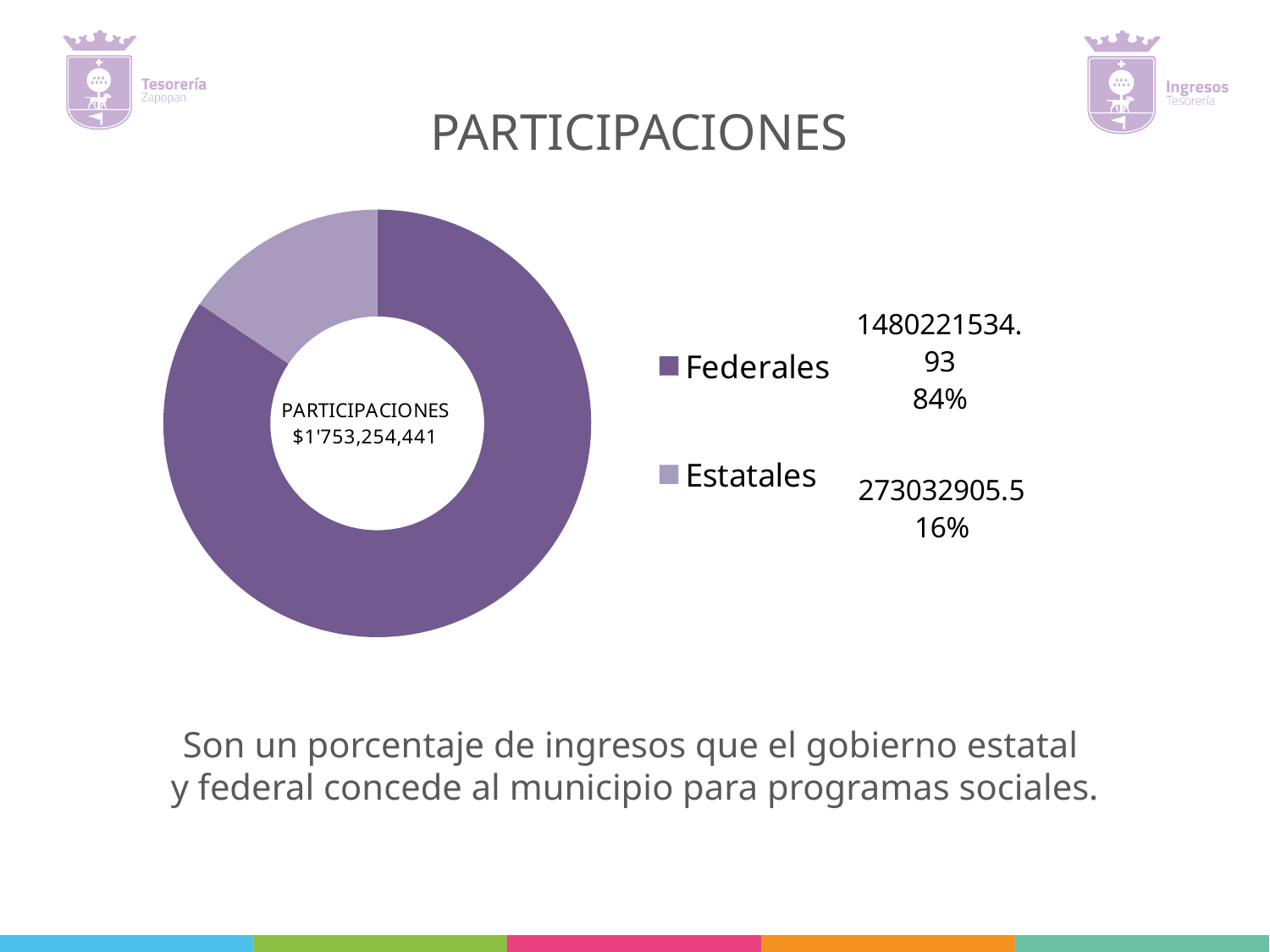
What percentage of the chart does the Estatales slice represent? 16% Which category has the largest slice of the chart? Federales How many categories does the chart show? 2 What total amount is printed in the centre of the chart? $1'753,254,441 Which category has the smallest slice of the chart? Estatales What is the value shown for Estatales? 273032905.5 Which is larger, Federales or Estatales? Federales What is the difference between the Federales and Estatales values? 1207188629.43 What is the title of the chart? PARTICIPACIONES What percentage of the chart does the Federales slice represent? 84% What is the value shown for Federales? 1480221534.93 What kind of chart is shown on the slide? donut (pie) chart